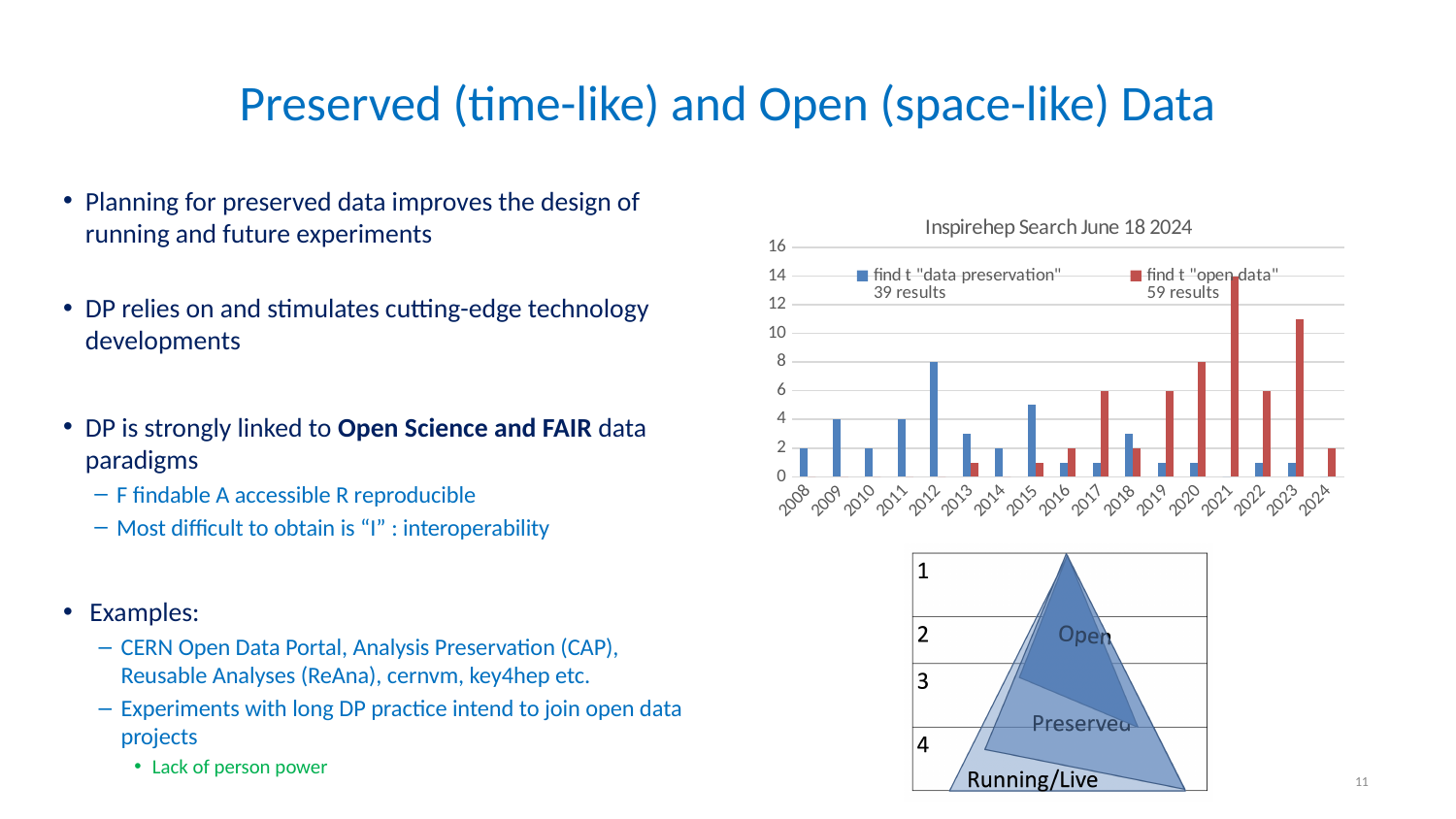
In the "Inspirehep Search June 18 2024" chart, is the value for "open data" in 2023 greater or less than 10? greater In the "Inspirehep Search June 18 2024" chart, which colour represents the "data preservation" series? blue In the "Inspirehep Search June 18 2024" chart, what is the value for "open data" in 2021? 14 In the "Inspirehep Search June 18 2024" chart, which is larger in 2020: the "data preservation" value or the "open data" value? open data According to the legend of the "Inspirehep Search June 18 2024" chart, how many results did the search for "open data" return? 59 results In the "Inspirehep Search June 18 2024" chart, is the value for "data preservation" in 2015 greater or less than 4? greater How many years are shown on the x axis of the "Inspirehep Search June 18 2024" chart? 17 How many series does the legend of the "Inspirehep Search June 18 2024" chart list? 2 In the "Inspirehep Search June 18 2024" chart, which year has the highest value for the "open data" series? 2021 In the "Inspirehep Search June 18 2024" chart, what is the value for "data preservation" in 2012? 8 What type of chart is shown under the title "Inspirehep Search June 18 2024"? bar chart In the "Inspirehep Search June 18 2024" chart, which year has the highest value for the "data preservation" series? 2012